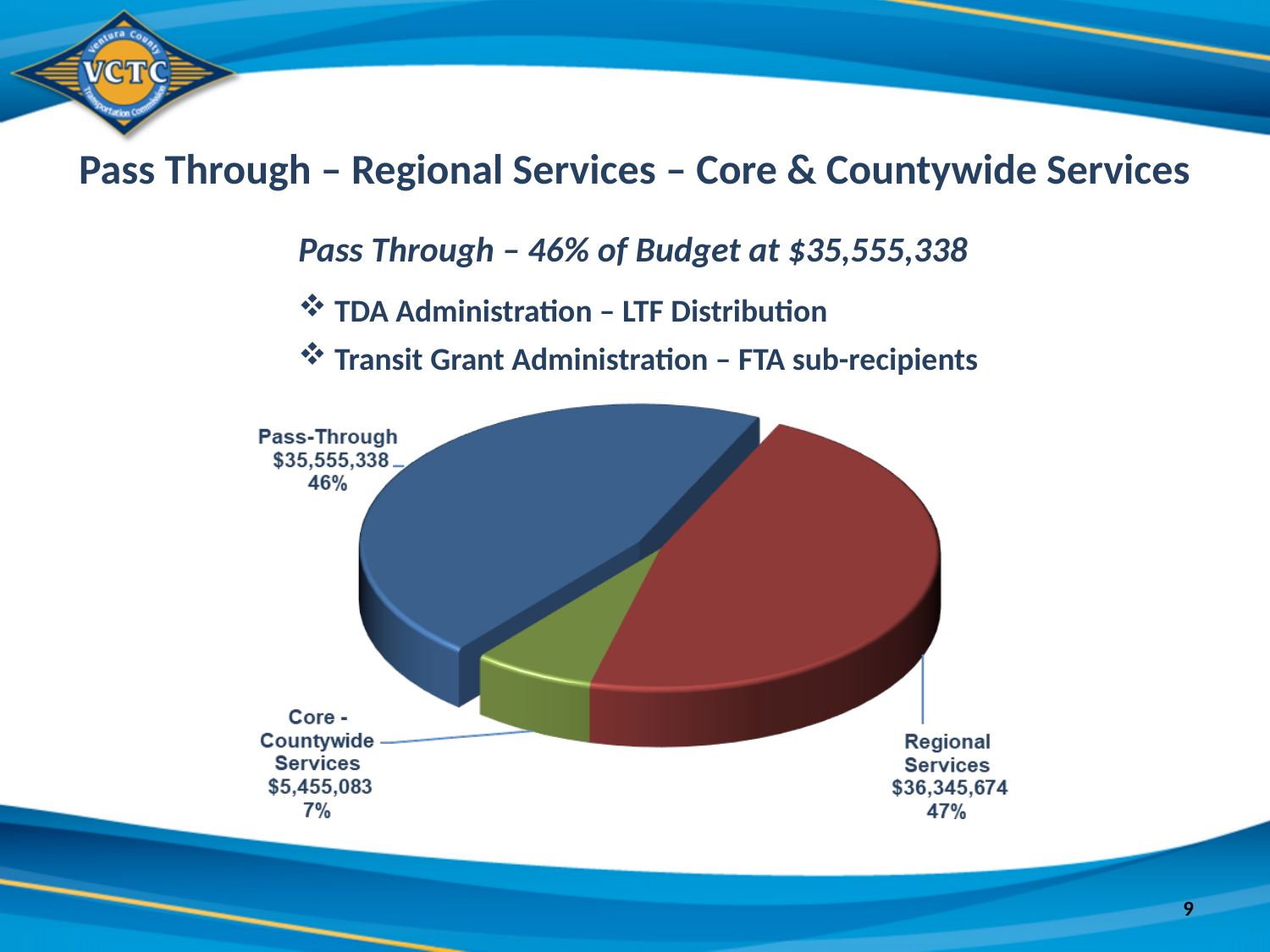
How many slices does the pie chart have? 3 What is the difference in dollars between the Regional Services slice and the Pass-Through slice? $790,336 Which is larger, the Pass-Through slice or the Core - Countywide Services slice? Pass-Through What share of the pie does Regional Services represent? 47% What is the dollar value of the Pass-Through slice? $35,555,338 Which slice of the pie chart is the smallest? Core - Countywide Services What colour is the Regional Services slice? Red What is the dollar value of the Regional Services slice? $36,345,674 What share of the pie does Core - Countywide Services represent? 7% Which slice of the pie chart is the largest? Regional Services What is the dollar value of the Core - Countywide Services slice? $5,455,083 What kind of chart is shown on the slide? Pie chart